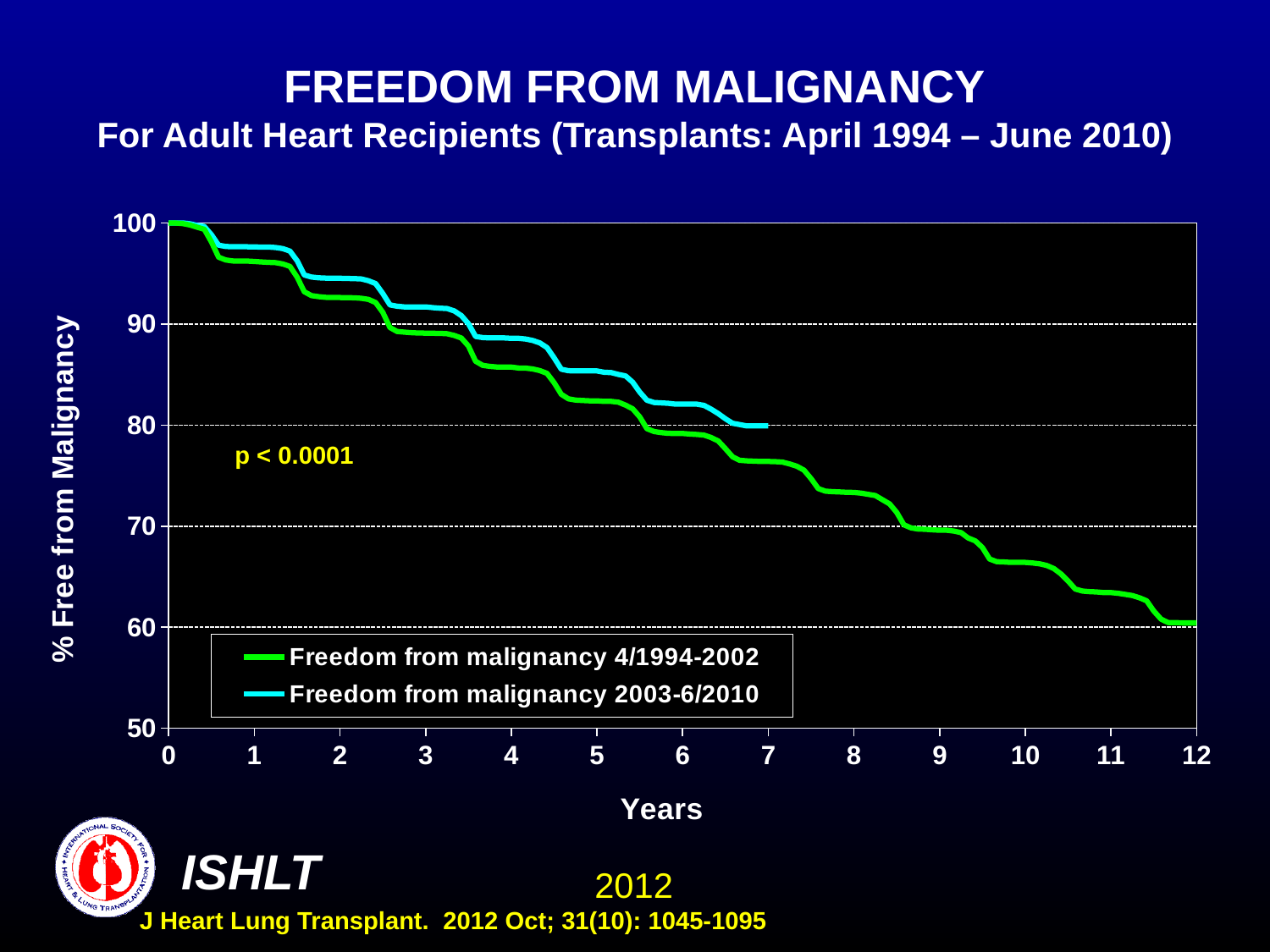
At year 5, which series has the higher value: 'Freedom from malignancy 4/1994-2002' or 'Freedom from malignancy 2003-6/2010'? Freedom from malignancy 2003-6/2010 Is the value for 'Freedom from malignancy 2003-6/2010' at year 5 greater or less than 80? greater Is the value for 'Freedom from malignancy 4/1994-2002' at year 8 greater or less than 70? greater What is the value of both series at year 0? 100 Is the value for 'Freedom from malignancy 4/1994-2002' at year 10 greater or less than 70? less Do the values of the 'Freedom from malignancy 4/1994-2002' series rise or fall as years increase? fall What kind of chart is shown on the slide? line chart What p-value is printed on the chart? p < 0.0001 How many series does the legend list? 2 What is the label of the y axis? % Free from Malignancy Which series extends further along the x axis? Freedom from malignancy 4/1994-2002